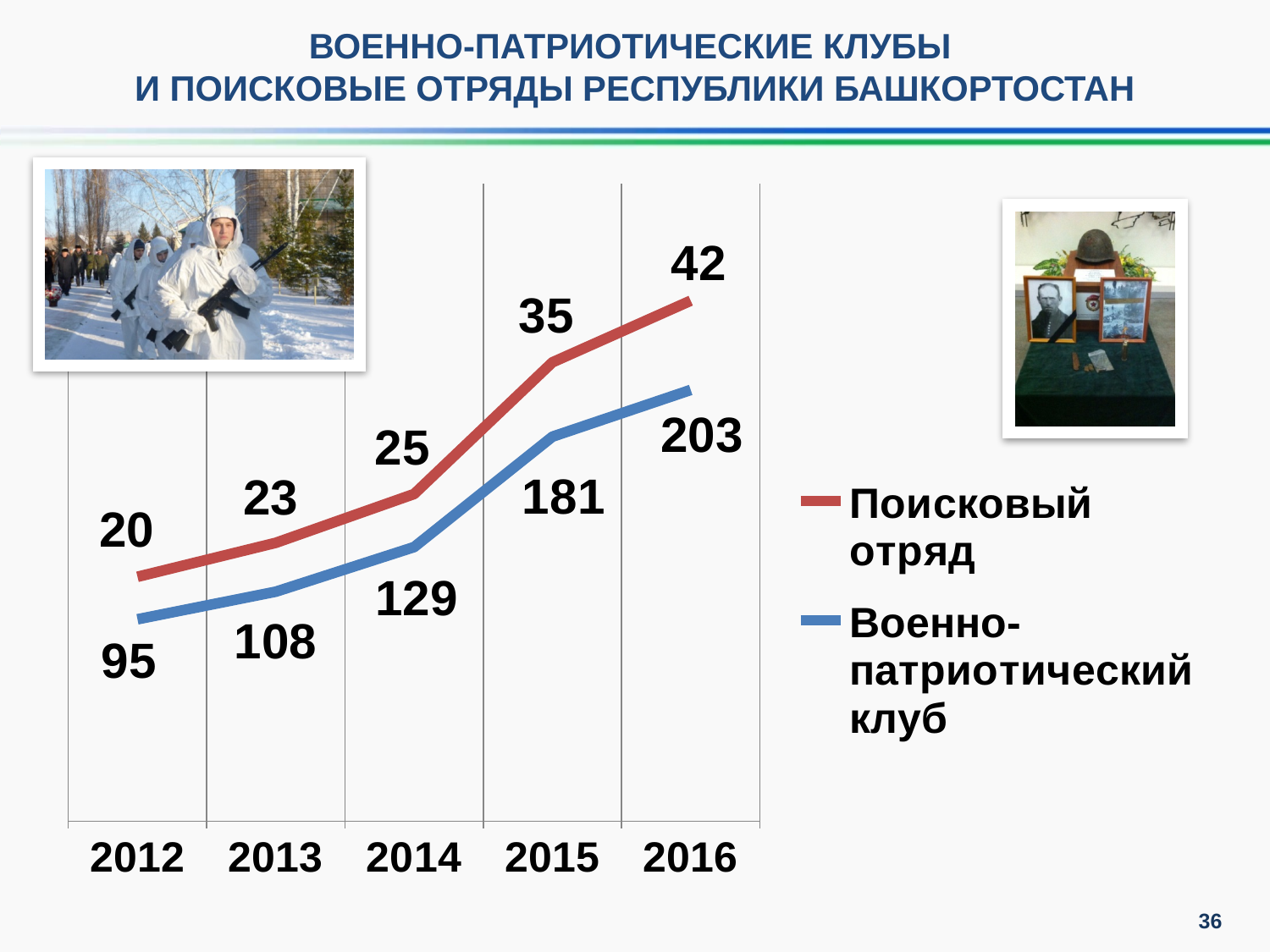
What is the difference between the Военно-патриотический клуб values in 2016 and 2012? 108 What type of chart is shown on the slide? line chart What is the value for Военно-патриотический клуб in 2015? 181 What is the value for Военно-патриотический клуб in 2012? 95 In which year is the value for Военно-патриотический клуб lowest? 2012 What is the difference between the Поисковый отряд values in 2015 and 2014? 10 How many series does the legend list? 2 What is the value for Поисковый отряд in 2014? 25 Which is larger: the Военно-патриотический клуб value in 2013 or in 2014? 2014 How many years are shown on the x axis? 5 In which year is the value for Поисковый отряд highest? 2016 Do the values for Поисковый отряд rise or fall from 2012 to 2016? rise